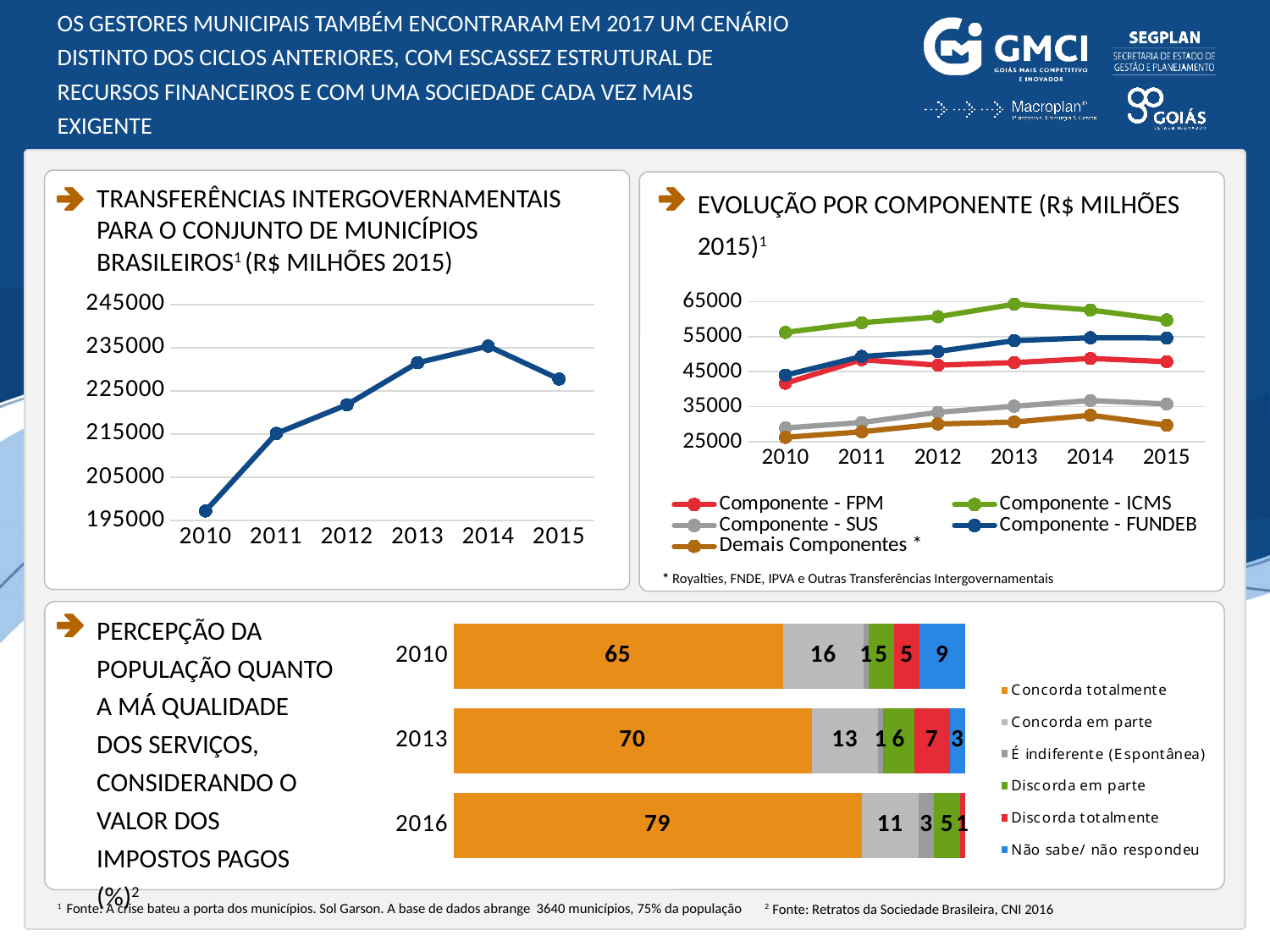
What kind of chart is the bottom chart (Percepção da população)? Stacked bar chart In the top-right chart (Evolução por componente), which component has the highest value in 2013? Componente - ICMS In the top-left chart (Transferências intergovernamentais), is the value for 2010 greater or less than 205000? less In the top-left chart (Transferências intergovernamentais), which year has the highest value? 2014 In the bottom chart (Percepção da população), how many series does the legend list? 6 In the bottom chart (Percepção da população), which year has the highest value for 'Concorda totalmente'? 2016 In the bottom chart (Percepção da população), what is the difference between the 'Concorda totalmente' values for 2016 and 2010? 14 In the bottom chart (Percepção da população), what is the value for 'Concorda totalmente' in 2016? 79 In the bottom chart (Percepção da população), what is the value for 'Discorda totalmente' in 2013? 7 In the top-right chart (Evolução por componente), how many series does the legend list? 5 In the bottom chart (Percepção da população), what is the value for 'Concorda em parte' in 2010? 16 In the top-left chart (Transferências intergovernamentais), how many years are plotted? 6